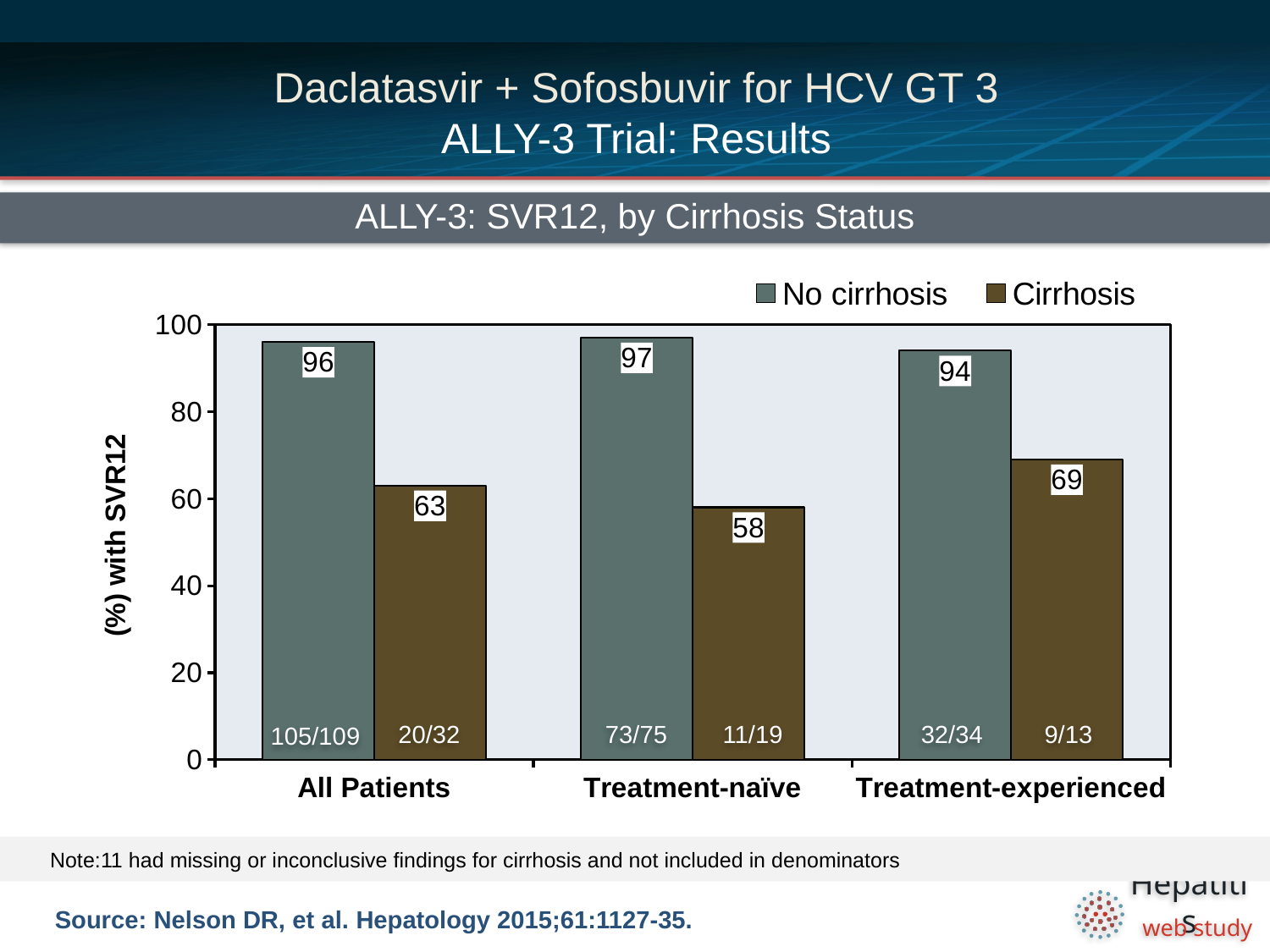
Which is larger: the Cirrhosis SVR12 rate for Treatment-experienced patients or for All Patients? Treatment-experienced What is the SVR12 rate for the Cirrhosis group among Treatment-naïve patients? 58 What is the SVR12 rate for the No cirrhosis group among All Patients? 96 What is the y-axis label of the chart? (%) with SVR12 Which category has the lowest SVR12 rate for the Cirrhosis series? Treatment-naïve What is the difference between the No cirrhosis and Cirrhosis SVR12 rates among All Patients? 33 How many patient categories are shown on the x axis? 3 What is the SVR12 rate for the Cirrhosis group among Treatment-experienced patients? 69 What kind of chart is shown on the slide? Bar chart How many series does the legend list? 2 Which category has the highest SVR12 rate for the No cirrhosis series? Treatment-naïve Is the Cirrhosis SVR12 rate for Treatment-naïve patients greater or less than 60? less